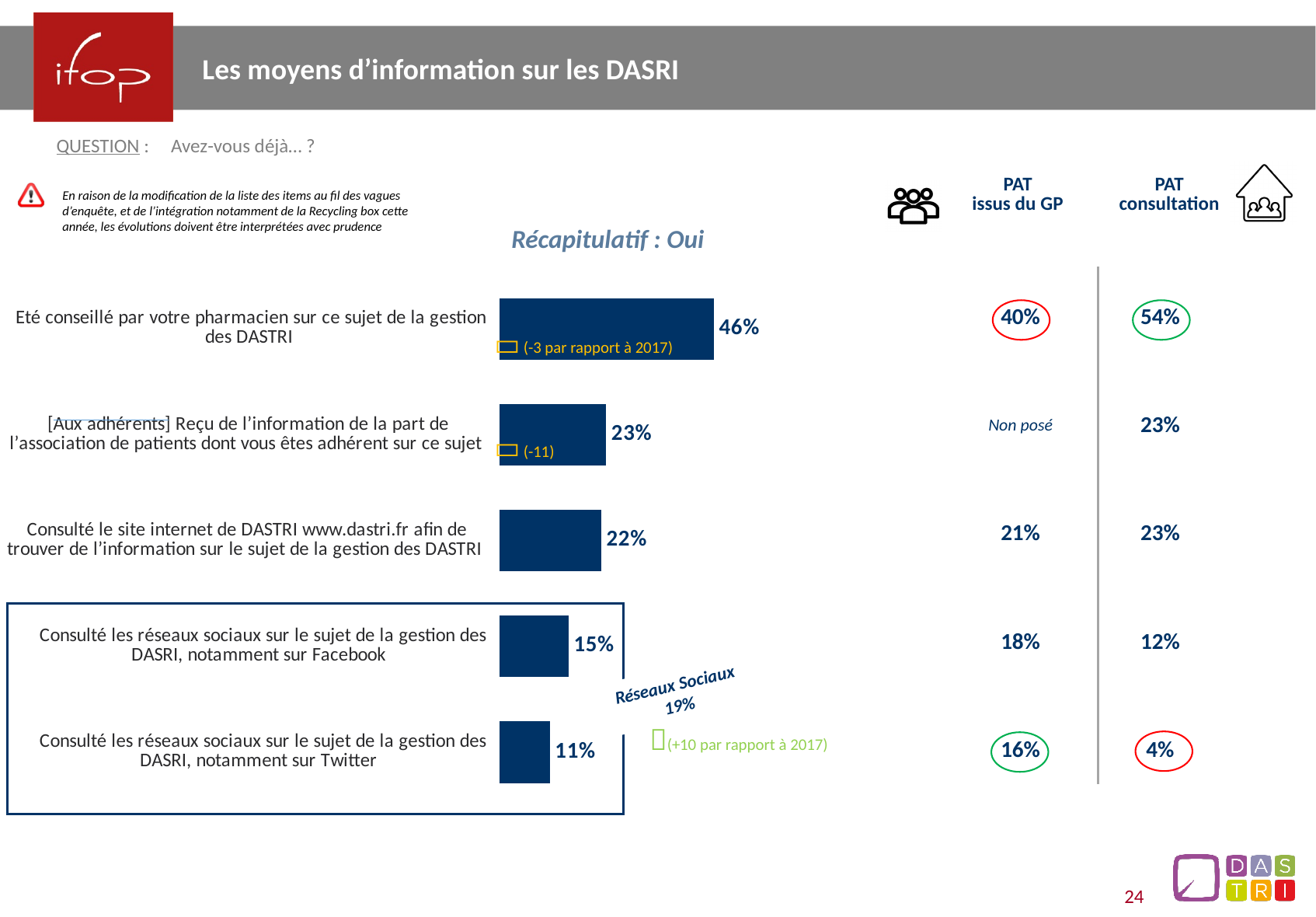
What is the combined 'Réseaux Sociaux' value shown on the chart? 19% What is the difference between the Facebook value and the Twitter value? 4% What is the value for 'Consulté le site internet de DASTRI www.dastri.fr'? 22% What kind of chart is shown on the slide? bar chart What is the value for 'Eté conseillé par votre pharmacien sur ce sujet de la gestion des DASRI'? 46% What is the value for 'Consulté les réseaux sociaux ... notamment sur Twitter'? 11% Which category has the highest value? Eté conseillé par votre pharmacien sur ce sujet de la gestion des DASRI What is the difference between the value for 'Eté conseillé par votre pharmacien' and the value for 'Reçu de l'information de la part de l'association de patients'? 23% Which category has the lowest value? Consulté les réseaux sociaux sur le sujet de la gestion des DASRI, notamment sur Twitter What is the title shown above the bar chart? Récapitulatif : Oui How many categories (bars) does the chart show? 5 Which is larger: the value for Facebook or the value for Twitter? Facebook